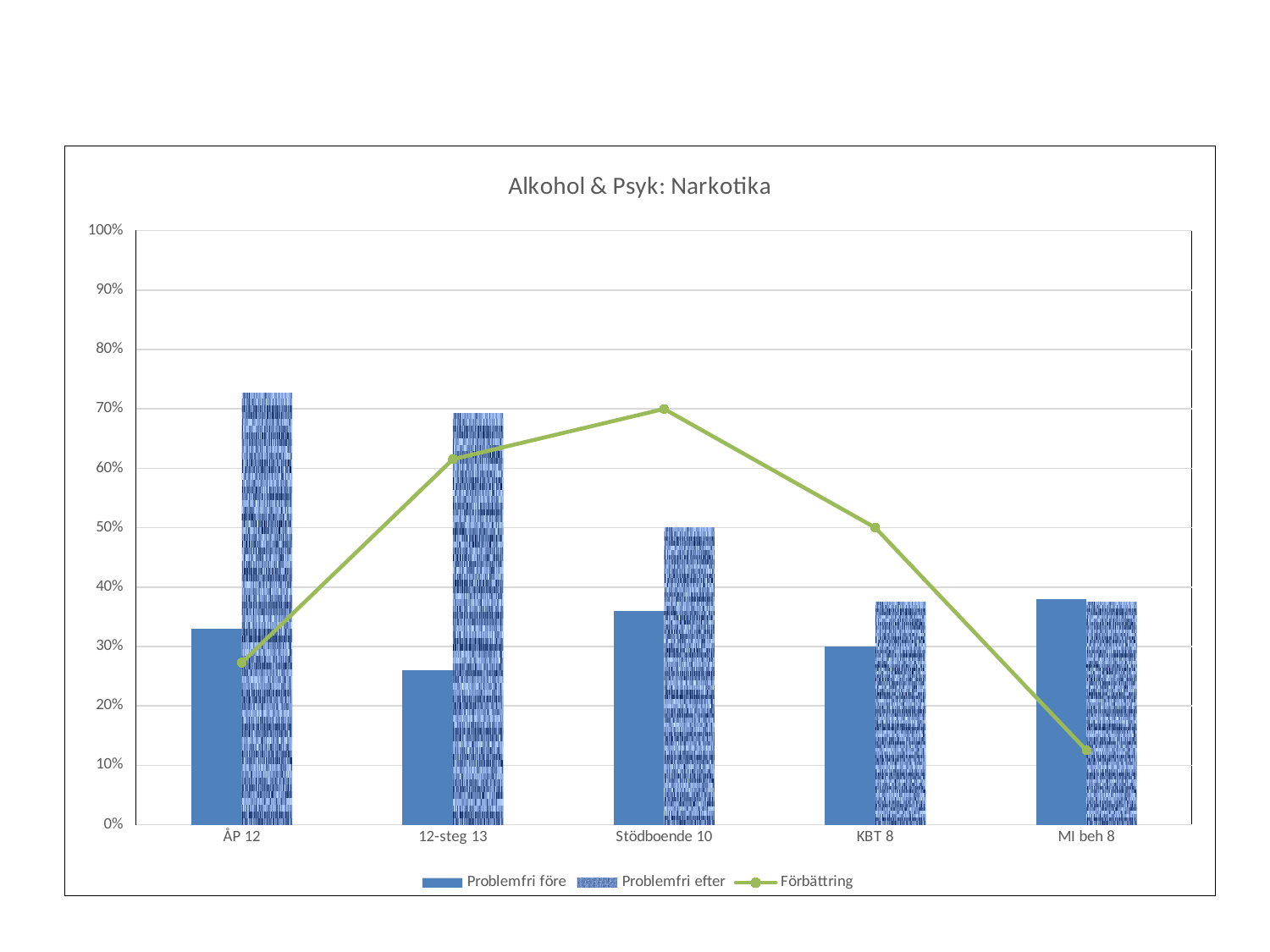
Which category has the highest Förbättring value? Stödboende 10 Which category has the lowest Förbättring value? MI beh 8 What is the title of the chart? Alkohol & Psyk: Narkotika What is the Förbättring value for Stödboende 10? 70% What is the Problemfri efter value for Stödboende 10? 50% Is the Problemfri efter value for ÅP 12 greater or less than 70%? greater Which category has the lowest Problemfri före value? 12-steg 13 How many series does the legend list? 3 How many categories are shown on the x axis? 5 What kind of chart is this? Bar chart with a line series Is the Problemfri före value for 12-steg 13 greater or less than 30%? less What is the Förbättring value for KBT 8? 50%